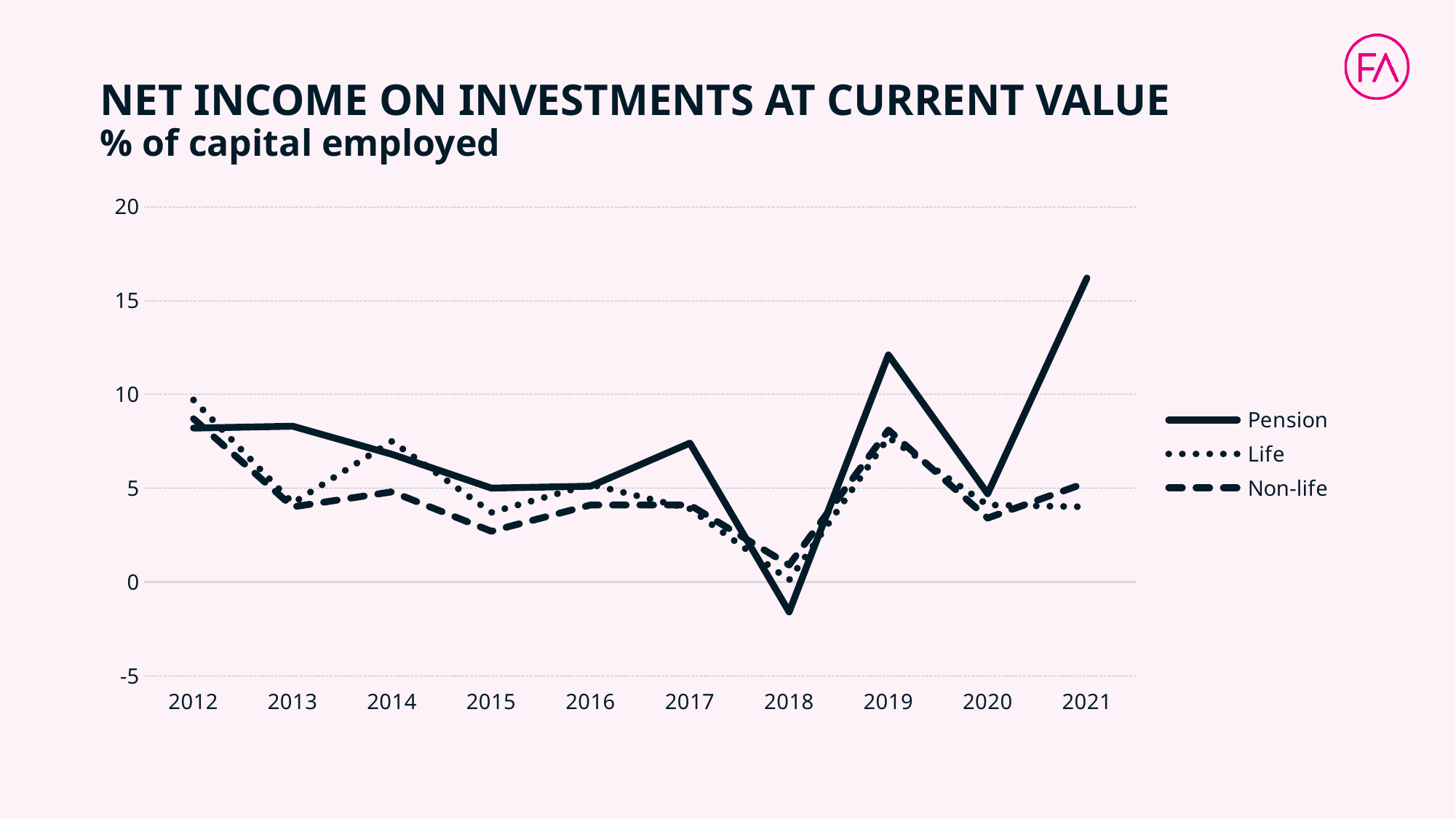
In which year is the Pension series at its lowest? 2018 How many years are shown on the x axis? 10 Is the value for Pension in 2018 greater or less than 0? less What kind of chart is shown on the slide? line chart In which year is the Life series at its lowest? 2018 In which year is the Pension series at its highest? 2021 Which series has the larger value in 2019, Pension or Non-life? Pension Is the value for Pension in 2021 greater or less than 15? greater How many series does the legend list? 3 Is the value for Non-life in 2015 greater or less than 5? less Does the Pension series rise or fall from 2020 to 2021? rise Which series has the larger value in 2021, Pension or Life? Pension